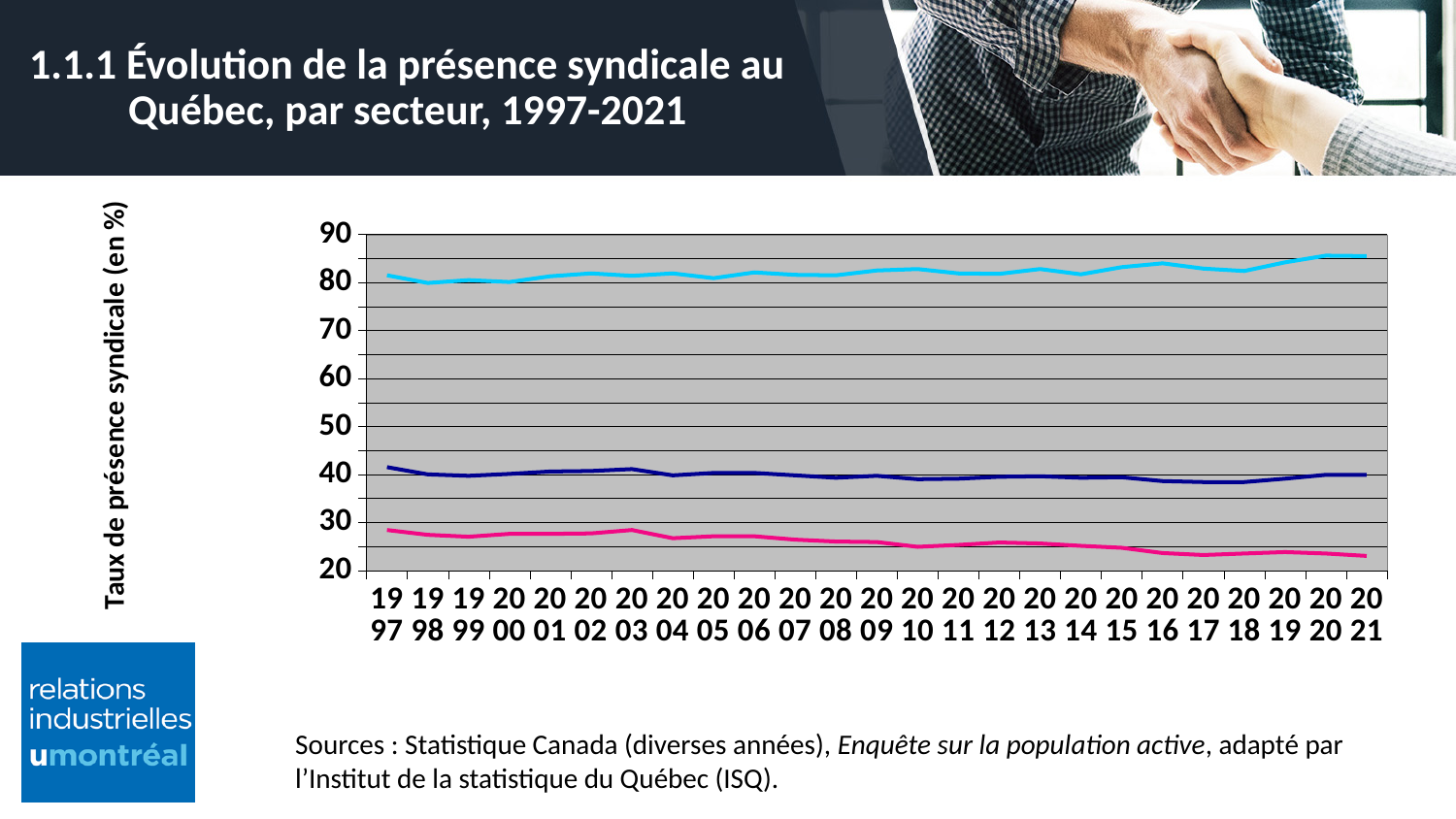
How many years are shown along the x axis of the chart? 25 What is the label of the vertical axis? Taux de présence syndicale (en %) Is the value of the light blue line in 2021 greater or less than 80? greater Which line has the lowest values throughout the period: the light blue, dark blue or pink line? pink Does the pink line rise or fall overall from 1997 to 2021? fall How many lines are plotted on the chart? 3 Is the value of the pink line in 2021 greater or less than 30? less What kind of chart is shown on the slide? line chart Is the value of the pink line in 1997 greater or less than 30? less Which line has the highest values throughout the period: the light blue, dark blue or pink line? light blue What is the first year shown on the x axis? 1997